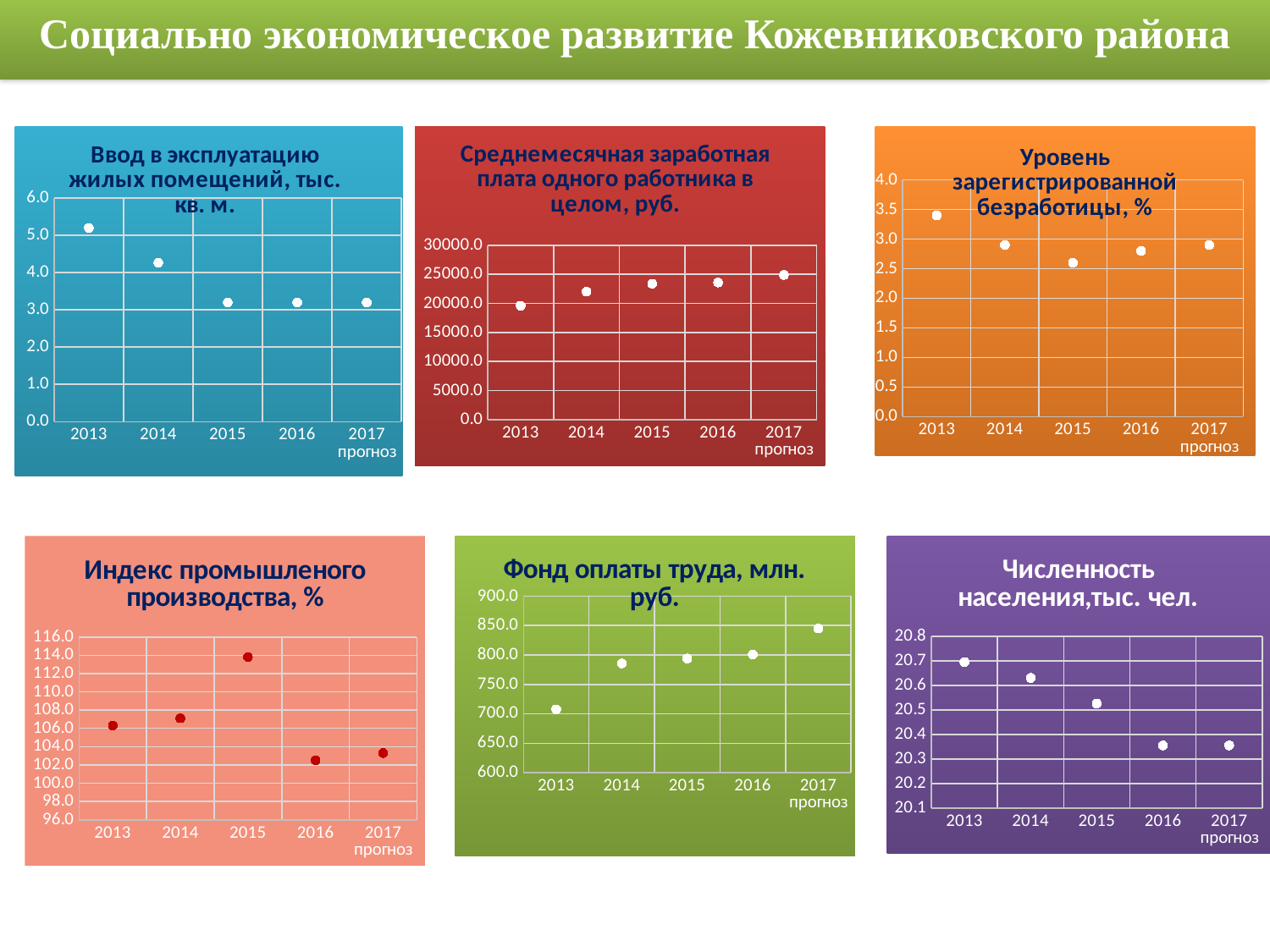
On the chart titled "Среднемесячная заработная плата одного работника в целом, руб.", which year has the lowest value? 2013 On the chart titled "Фонд оплаты труда, млн. руб.", is the value for 2017 greater or less than 800.0? greater On the chart titled "Численность населения,тыс. чел.", do the values generally rise or fall from 2013 to 2017? fall On the chart titled "Уровень зарегистрированной безработицы, %", which year has the lowest value? 2015 On the chart titled "Индекс промышленого производства, %", which is larger, the value for 2014 or the value for 2016? 2014 How many data points are plotted on the chart titled "Ввод в эксплуатацию жилых помещений, тыс. кв. м."? 5 On the chart titled "Индекс промышленого производства, %", which year has the highest value? 2015 On the chart titled "Среднемесячная заработная плата одного работника в целом, руб.", is the value for 2013 greater or less than 20000.0? less On the chart titled "Среднемесячная заработная плата одного работника в целом, руб.", do the values generally rise or fall from 2013 to 2017? rise On the chart titled "Ввод в эксплуатацию жилых помещений, тыс. кв. м.", which year has the highest value? 2013 On the chart titled "Уровень зарегистрированной безработицы, %", is the value for 2013 greater or less than 3.0? greater